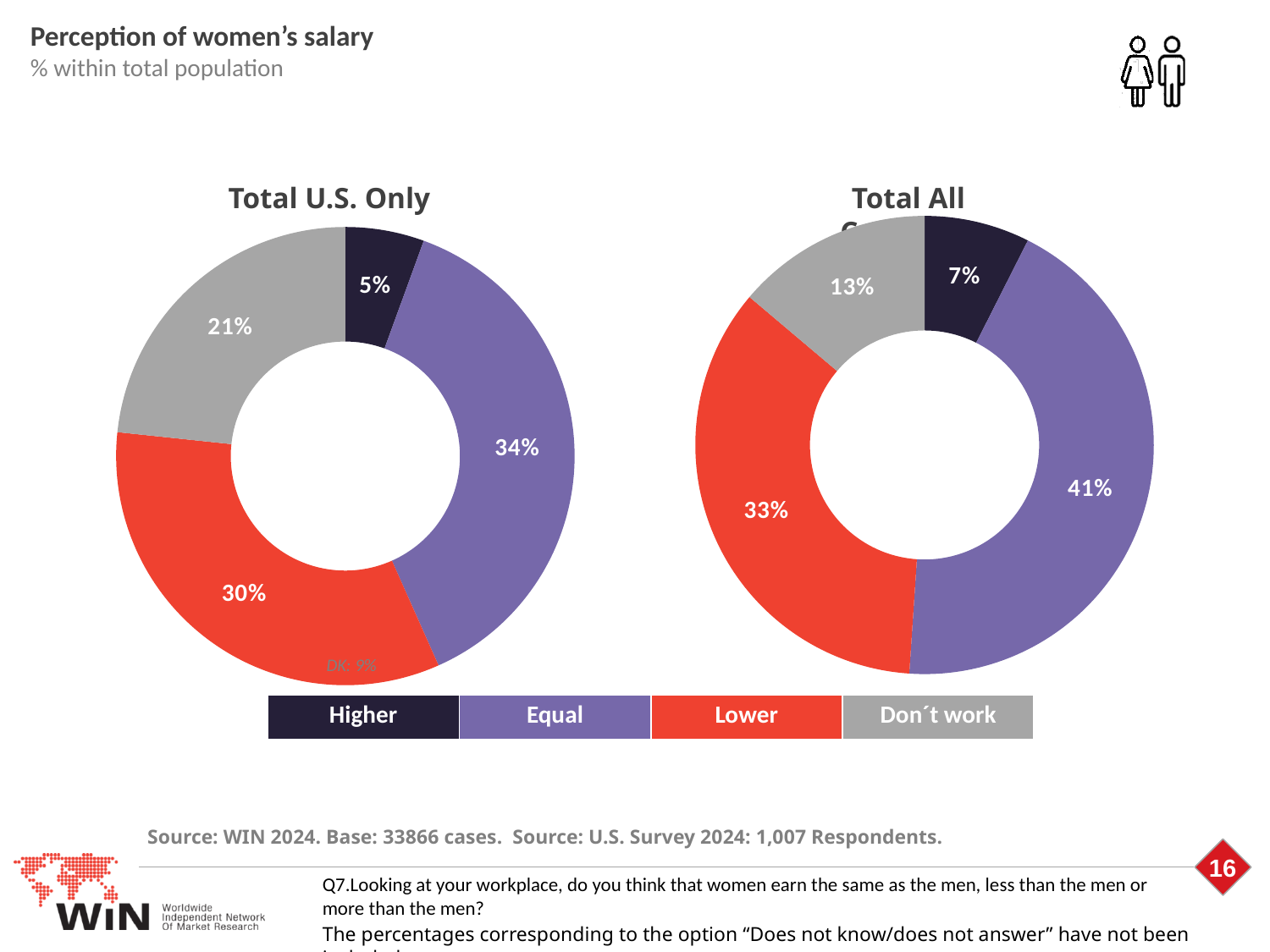
What is the difference between the Equal share in the right-hand chart (Total All) and the Equal share in the Total U.S. Only chart? 7 percentage points In the right-hand chart (Total All), what percentage is shown for Lower? 33% In the Total U.S. Only chart, what percentage is shown for Equal? 34% Which colour represents the Lower category in the legend? Red What type of chart is used on this slide? Donut (pie) chart In the right-hand chart (Total All), what percentage is shown for Don't work? 13% In the right-hand chart (Total All), which category has the smallest share? Higher Is the Don't work share larger in the Total U.S. Only chart or in the right-hand chart (Total All)? Total U.S. Only In the Total U.S. Only chart, what percentage is shown for Higher? 5% In the Total U.S. Only chart, what is the difference between the Equal and Lower shares? 4 percentage points In the Total U.S. Only chart, which category has the largest share? Equal How many categories does the legend list? 4